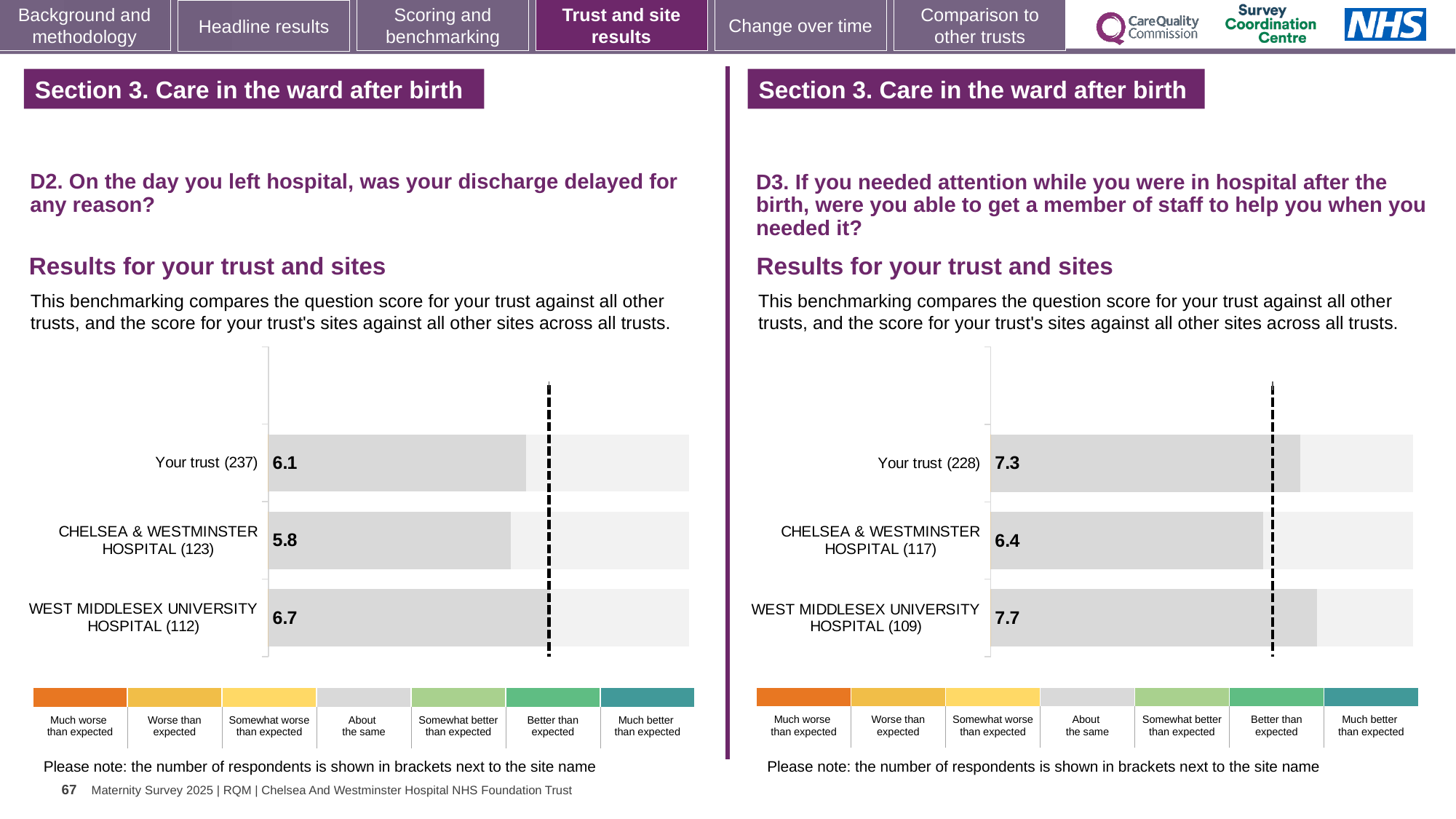
In the D3 chart on the right, is the score for Your trust (228) larger or smaller than the score for CHELSEA & WESTMINSTER HOSPITAL (117)? larger In the D2 chart on the left, what is the difference between the scores for WEST MIDDLESEX UNIVERSITY HOSPITAL (112) and CHELSEA & WESTMINSTER HOSPITAL (123)? 0.9 In the D2 chart on the left, what is the score for Your trust (237)? 6.1 In the D3 chart on the right, what is the score for WEST MIDDLESEX UNIVERSITY HOSPITAL (109)? 7.7 In the D2 chart on the left, which site or trust has the highest score? WEST MIDDLESEX UNIVERSITY HOSPITAL (112) What type of chart is used in the D3 chart on the right? bar chart In the D3 chart on the right, which site or trust has the lowest score? CHELSEA & WESTMINSTER HOSPITAL (117) How many bars are shown in the D2 chart on the left? 3 In the D3 chart on the right, what is the difference between the scores for WEST MIDDLESEX UNIVERSITY HOSPITAL (109) and Your trust (228)? 0.4 In the D2 chart on the left, what is the score for CHELSEA & WESTMINSTER HOSPITAL (123)? 5.8 In the D2 chart on the left, which site or trust has the lowest score? CHELSEA & WESTMINSTER HOSPITAL (123) In the D3 chart on the right, what is the score for Your trust (228)? 7.3